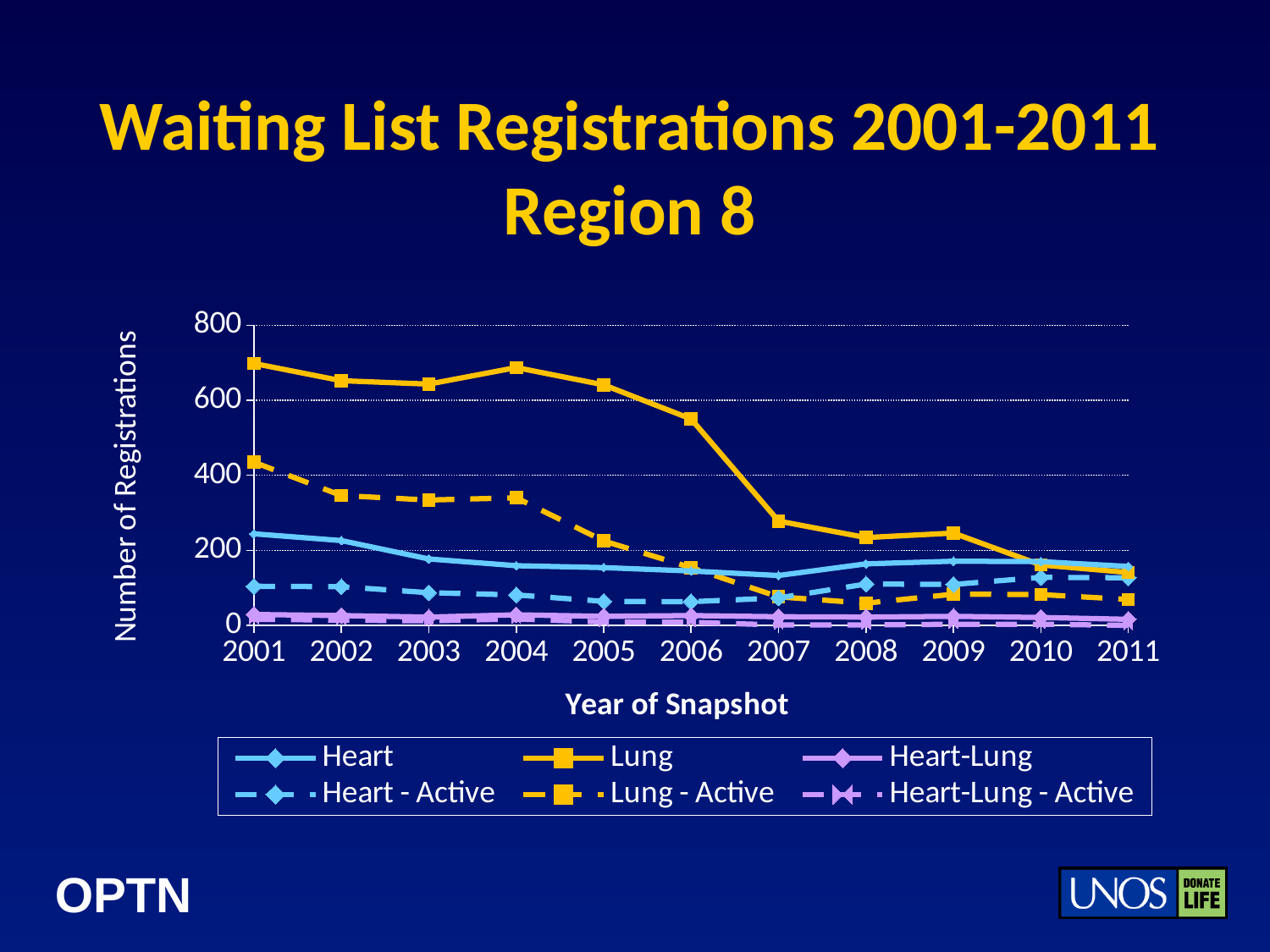
Is the value for Lung - Active in 2001 greater or less than 400? greater Is the value for Lung in 2007 greater or less than 400? less How many series does the legend list? 6 Which series has the highest value in 2001? Lung What is the title of the x axis? Year of Snapshot Which series has the lowest values across the chart? Heart-Lung - Active What kind of chart is shown on the slide? line chart In 2005, which is larger: Lung or Heart? Lung Is the value for Lung in 2001 greater or less than 600? greater How many years are plotted along the x axis? 11 Does the Lung series rise or fall from 2001 to 2011? fall